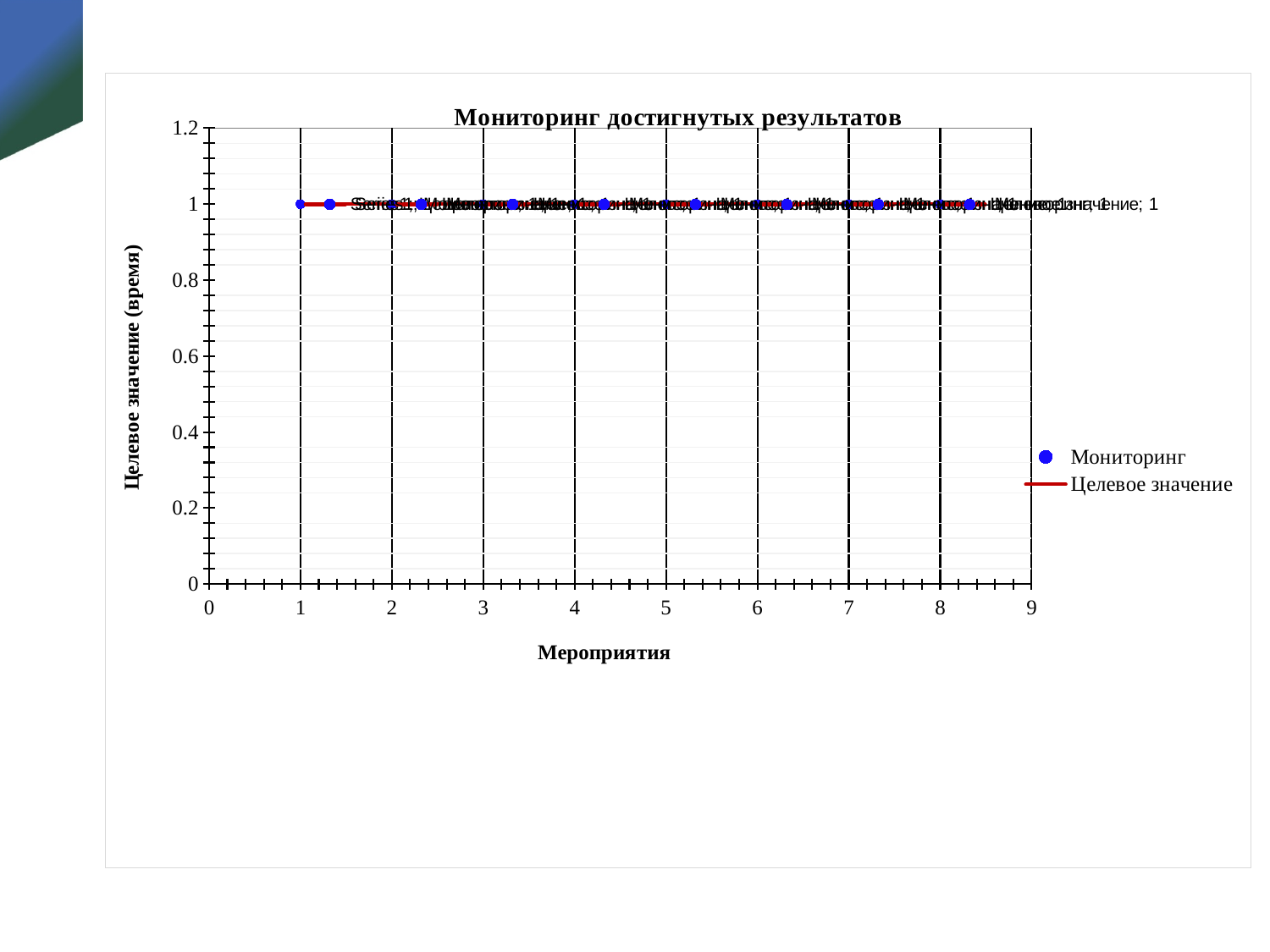
Do the values of the Целевое значение series rise, fall, or stay flat along the x axis? stay flat What is the title of the chart? Мониторинг достигнутых результатов What kind of chart is shown on the slide? scatter chart What is the label of the x axis? Мероприятия What is the highest value shown on the y axis? 1.2 Is the value of the Мониторинг series at x = 2 greater or less than 0.8? greater Is the value of the Целевое значение series at x = 5 greater or less than 1.2? less How many series does the chart legend list? 2 What is the value of the Мониторинг series at x = 8? 1 What is the value of the Целевое значение series at x = 1? 1